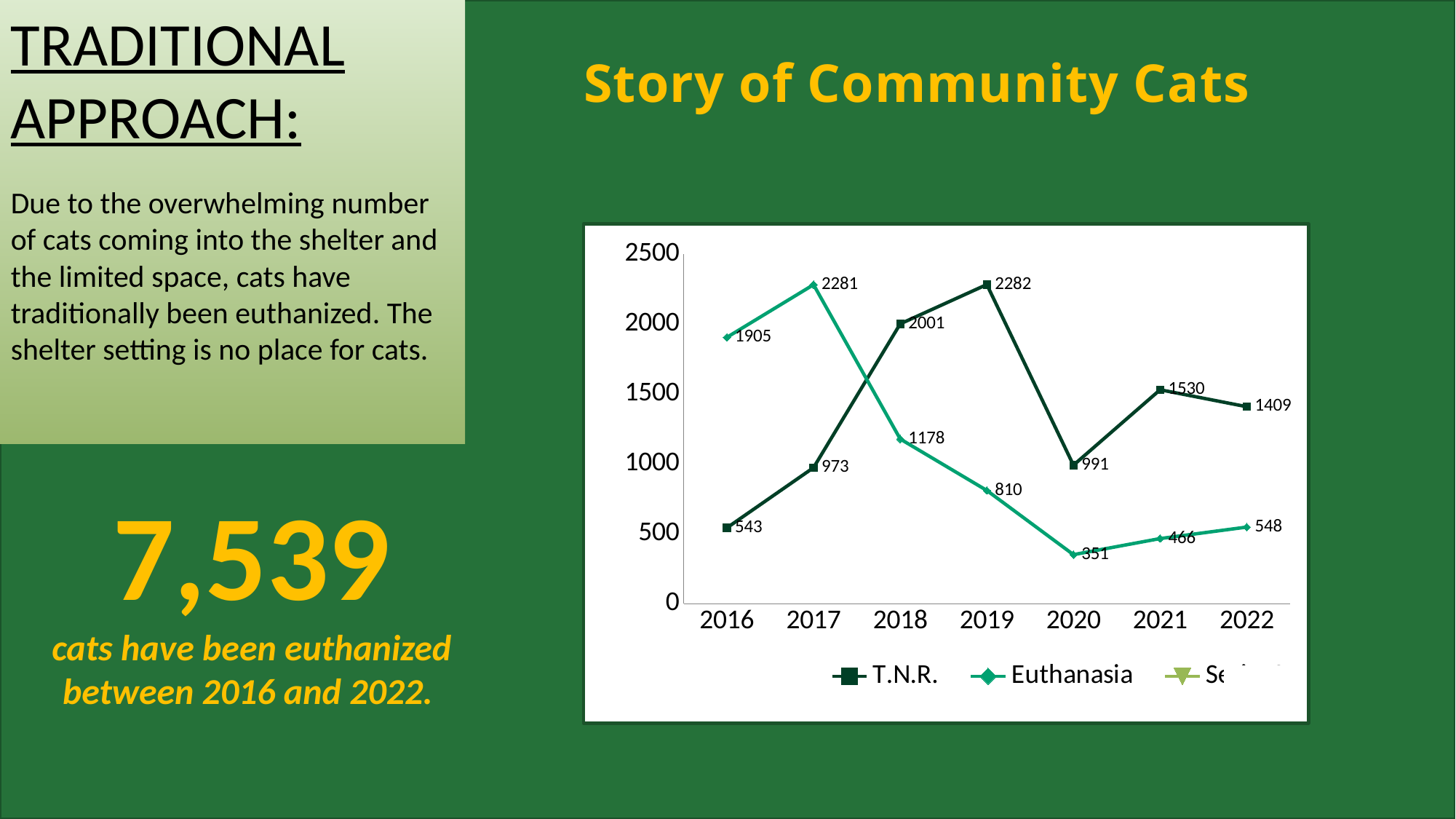
In which year is the Euthanasia value highest? 2017 What is the Euthanasia value for 2020? 351 Does the Euthanasia series rise or fall from 2017 to 2020? Fall What is the T.N.R. value for 2022? 1409 What is the difference between the T.N.R. values for 2021 and 2022? 121 In which year is the Euthanasia value lowest? 2020 What is the difference between the Euthanasia and T.N.R. values in 2016? 1362 What is the T.N.R. value for 2019? 2282 What kind of chart is shown on the slide? Line chart How many years are shown on the x axis? 7 In which year is the T.N.R. value highest? 2019 In 2018, which is larger: T.N.R. or Euthanasia? T.N.R.